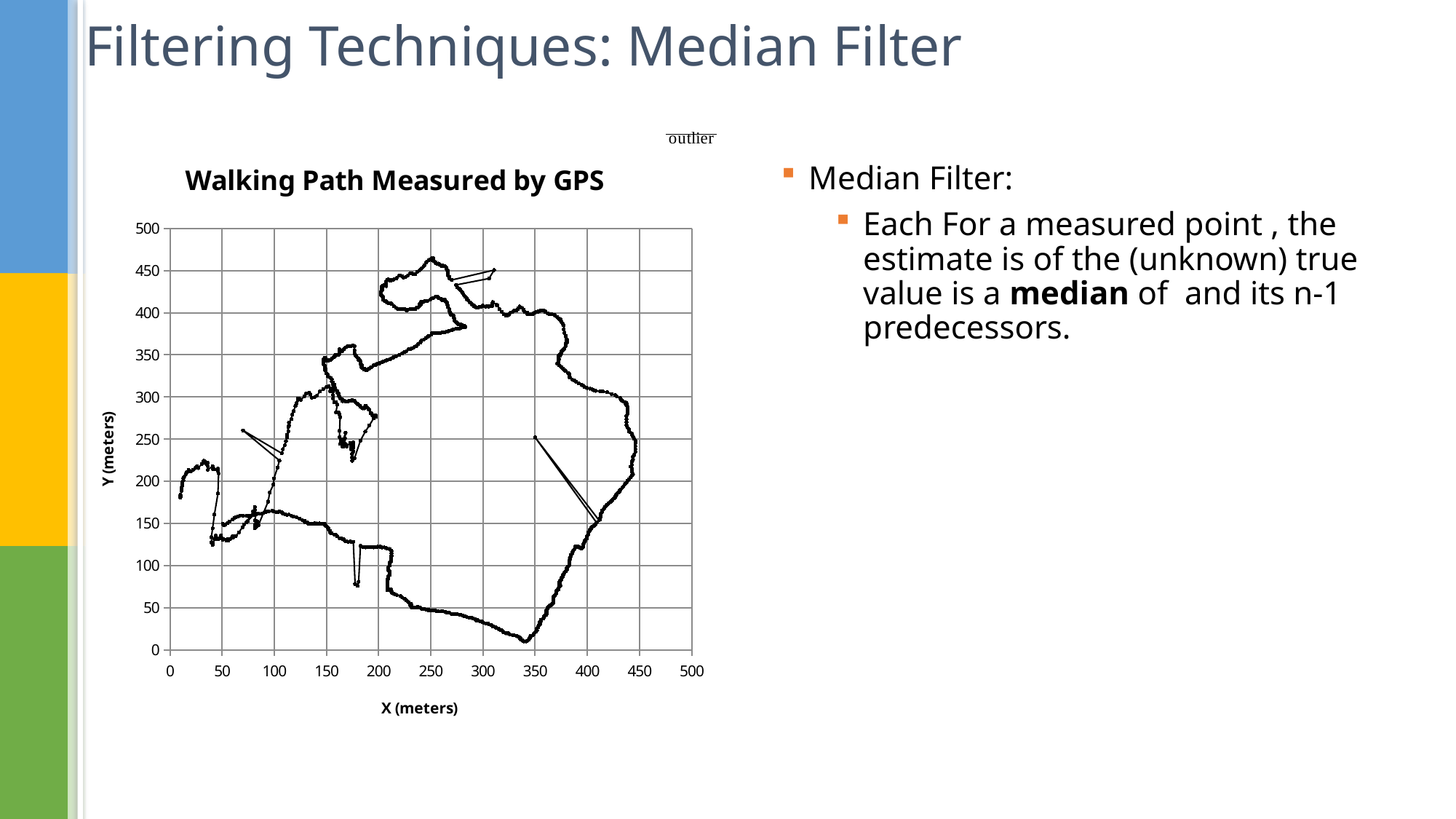
Is the Y value of the walking path at X = 350 near the bottom of the loop greater or less than 50? less What is the highest value shown on the y axis of the chart? 500 What kind of chart is shown on the slide? scatter chart Is the smallest X value reached by the walking path greater or less than 50? less What is the title of the chart? Walking Path Measured by GPS Is the largest X value reached by the walking path greater or less than 400? greater What is the label of the x axis of the chart? X (meters)